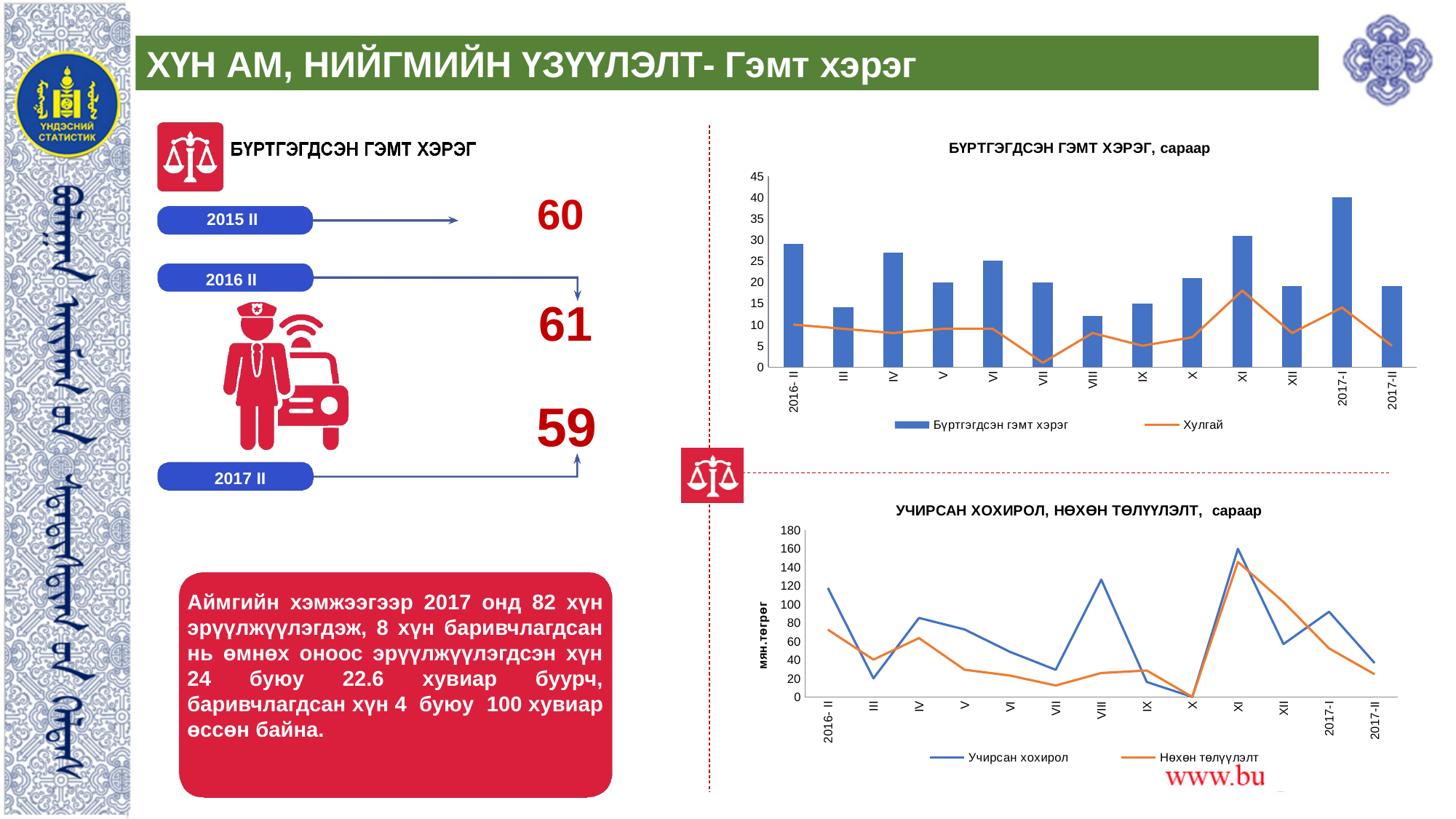
In the chart titled 'УЧИРСАН ХОХИРОЛ, НӨХӨН ТӨЛҮҮЛЭЛТ, сараар', which month has the highest value for 'Учирсан хохирол'? XI In the chart titled 'УЧИРСАН ХОХИРОЛ, НӨХӨН ТӨЛҮҮЛЭЛТ, сараар', is the 'Учирсан хохирол' value for VIII greater or less than 100? greater In the chart titled 'БҮРТГЭГДСЭН ГЭМТ ХЭРЭГ, сараар', what kind of chart is used? A bar chart combined with a line In the chart titled 'БҮРТГЭГДСЭН ГЭМТ ХЭРЭГ, сараар', is the 'Бүртгэгдсэн гэмт хэрэг' value for VIII greater or less than 15? less In the chart titled 'БҮРТГЭГДСЭН ГЭМТ ХЭРЭГ, сараар', how many months are shown on the x axis? 13 In the chart titled 'УЧИРСАН ХОХИРОЛ, НӨХӨН ТӨЛҮҮЛЭЛТ, сараар', what kind of chart is used? Line chart In the chart titled 'БҮРТГЭГДСЭН ГЭМТ ХЭРЭГ, сараар', which month has the shortest bar for 'Бүртгэгдсэн гэмт хэрэг'? VIII In the chart titled 'БҮРТГЭГДСЭН ГЭМТ ХЭРЭГ, сараар', how many series does the legend list? 2 In the chart titled 'БҮРТГЭГДСЭН ГЭМТ ХЭРЭГ, сараар', which month has the tallest bar for 'Бүртгэгдсэн гэмт хэрэг'? 2017-I In the chart titled 'БҮРТГЭГДСЭН ГЭМТ ХЭРЭГ, сараар', which series is drawn as an orange line? Хулгай In the chart titled 'БҮРТГЭГДСЭН ГЭМТ ХЭРЭГ, сараар', is the 'Бүртгэгдсэн гэмт хэрэг' value for 2017-I greater or less than 35? greater In the chart titled 'БҮРТГЭГДСЭН ГЭМТ ХЭРЭГ, сараар', which has the larger 'Бүртгэгдсэн гэмт хэрэг' bar, XI or XII? XI